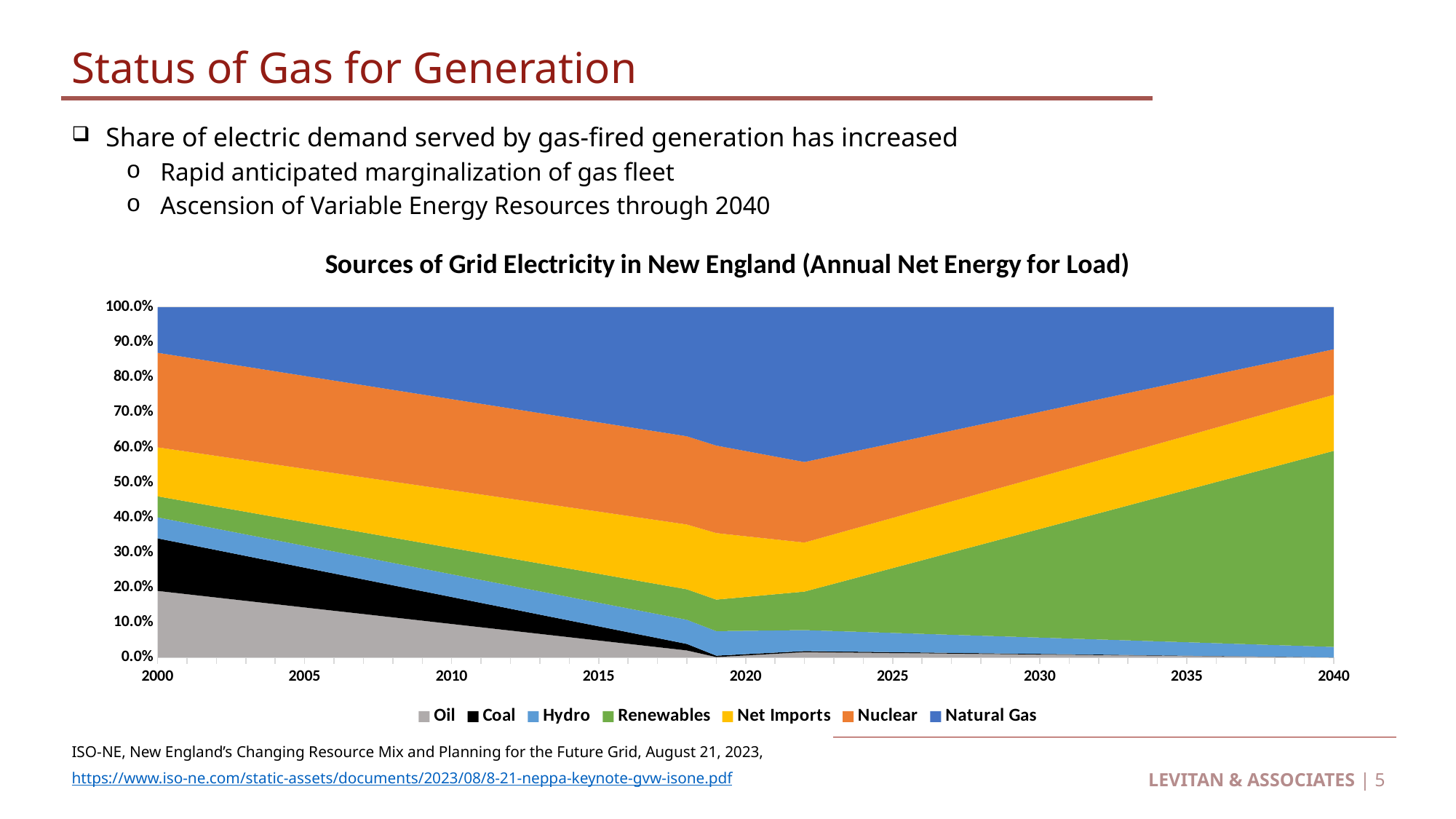
Which series is shown in green in the chart? Renewables What is the last year shown on the x axis of the chart? 2040 Which source has the largest share in 2040? Renewables How many series does the chart legend list? 7 What is the first year shown on the x axis of the chart? 2000 How many year labels are shown on the x axis? 9 What kind of chart is shown on the slide? Stacked area chart What is the title of the chart? Sources of Grid Electricity in New England (Annual Net Energy for Load) In 2040, which is larger: the share of Renewables or the share of Natural Gas? Renewables Does the share of Renewables rise or fall between 2020 and 2040? Rise Is the share of Oil in 2000 greater or less than 10.0%? greater Does the share of Oil rise or fall between 2000 and 2020? Fall